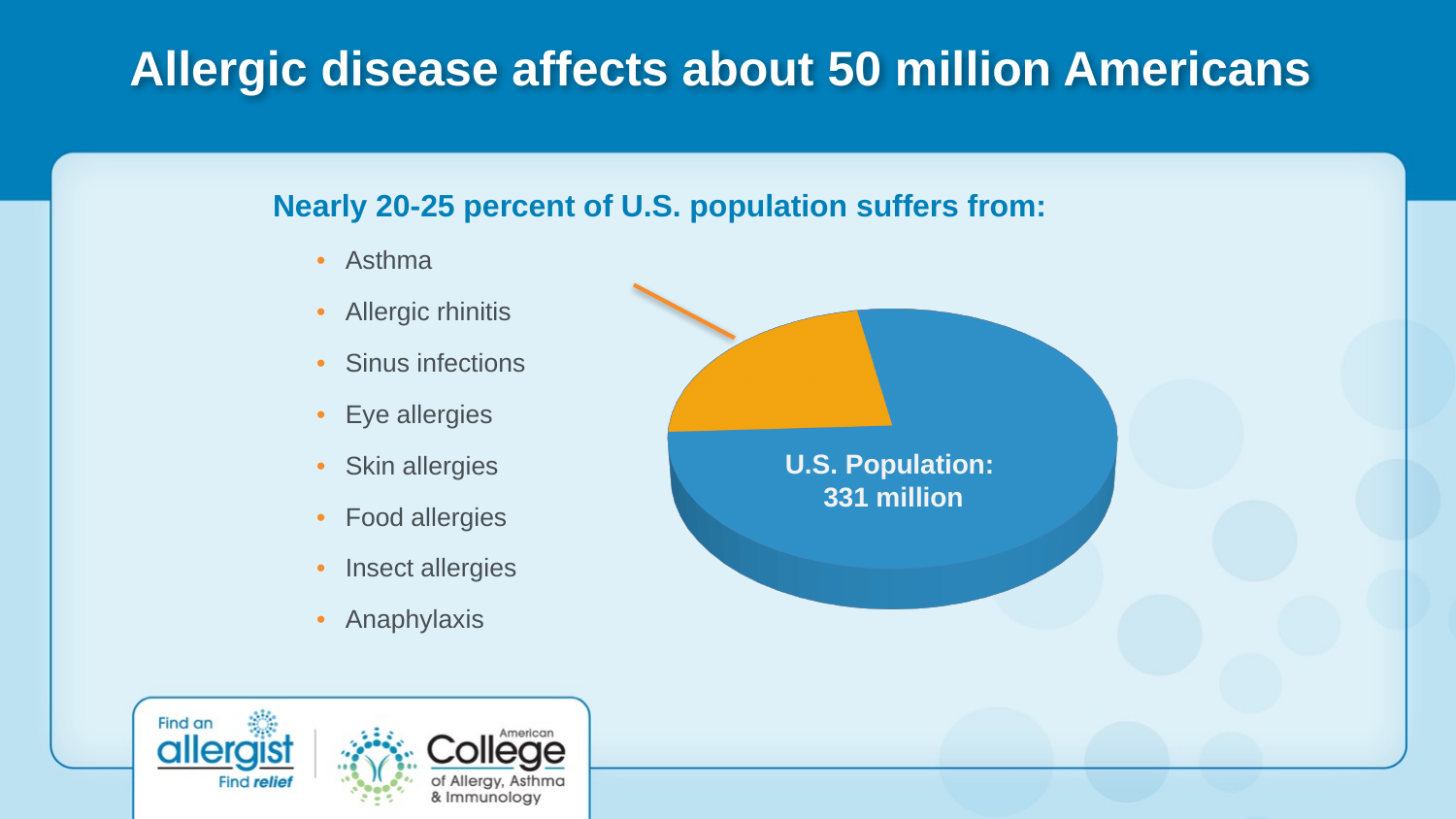
What colour is the slice that the arrow on the slide points to? Orange What kind of chart is shown on the slide? Pie chart Which slice of the pie chart is the smallest? The orange slice How many slices does the pie chart have? 2 Does the pie chart include a legend? No Which slice of the pie chart is larger, the blue one or the orange one? The blue one What label is printed on the large blue slice of the pie chart? U.S. Population: 331 million What value is printed on the pie chart for the U.S. Population? 331 million